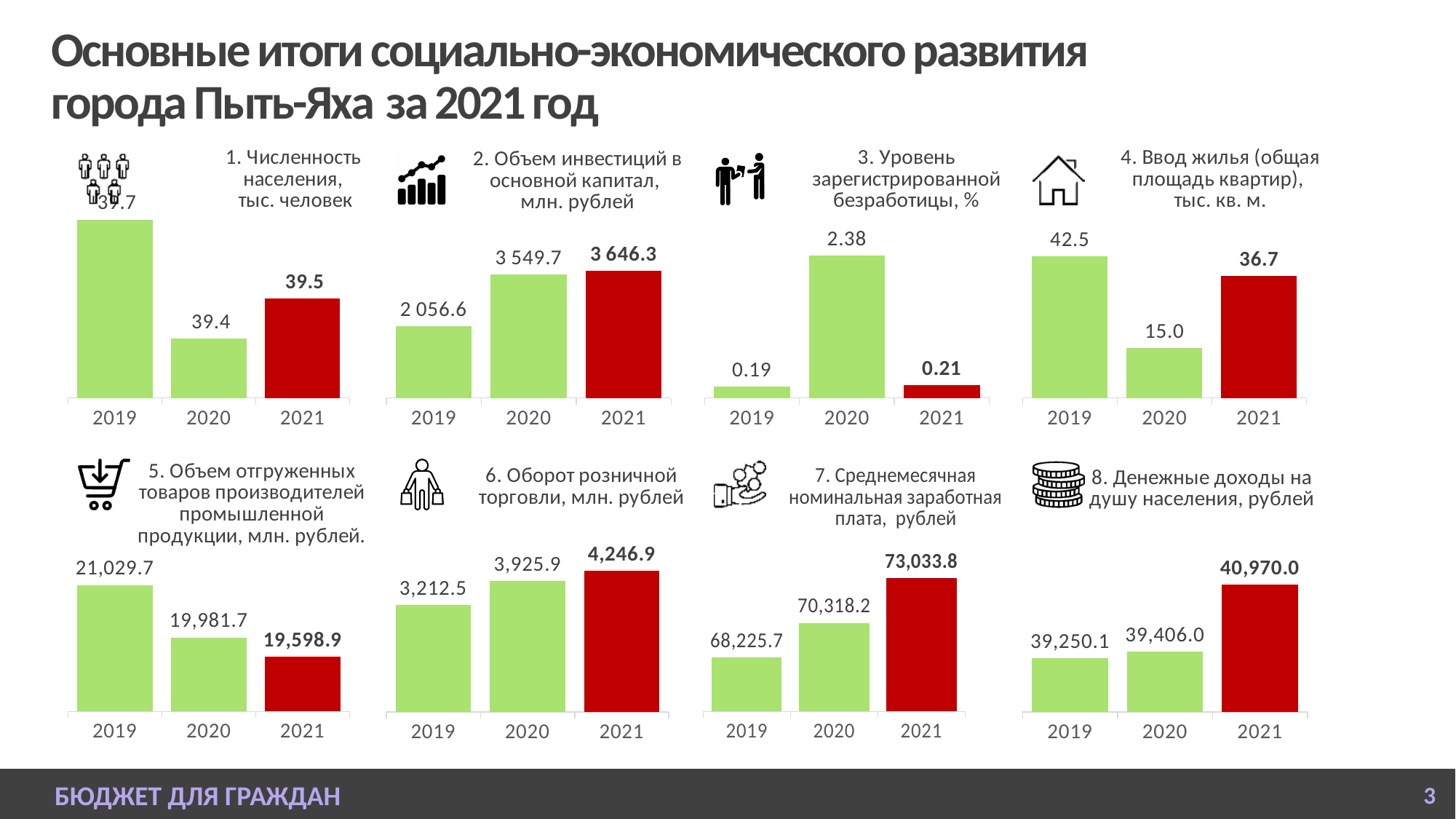
In the chart "5. Объем отгруженных товаров производителей промышленной продукции, млн. рублей.", do the values rise or fall from 2019 to 2021? fall In the chart "4. Ввод жилья (общая площадь квартир), тыс. кв. м.", what is the value for 2020? 15.0 In the chart "8. Денежные доходы на душу населения, рублей", what is the value for 2021? 40,970.0 What type of chart is "6. Оборот розничной торговли, млн. рублей"? bar chart In the chart "3. Уровень зарегистрированной безработицы, %", what is the difference between the 2020 and 2021 values? 2.17 In the chart "2. Объем инвестиций в основной капитал, млн. рублей", what colour is the bar for 2021? red In the chart "6. Оборот розничной торговли, млн. рублей", what is the difference between the 2021 and 2020 values? 321.0 In the chart "2. Объем инвестиций в основной капитал, млн. рублей", what is the value for 2021? 3 646.3 In the chart "7. Среднемесячная номинальная заработная плата, рублей", which year has the lowest value? 2019 In the chart "3. Уровень зарегистрированной безработицы, %", which year has the highest value? 2020 In the chart "1. Численность населения, тыс. человек", which is larger: the value for 2020 or the value for 2021? 2021 How many years (categories) are shown in the chart "4. Ввод жилья (общая площадь квартир), тыс. кв. м."? 3